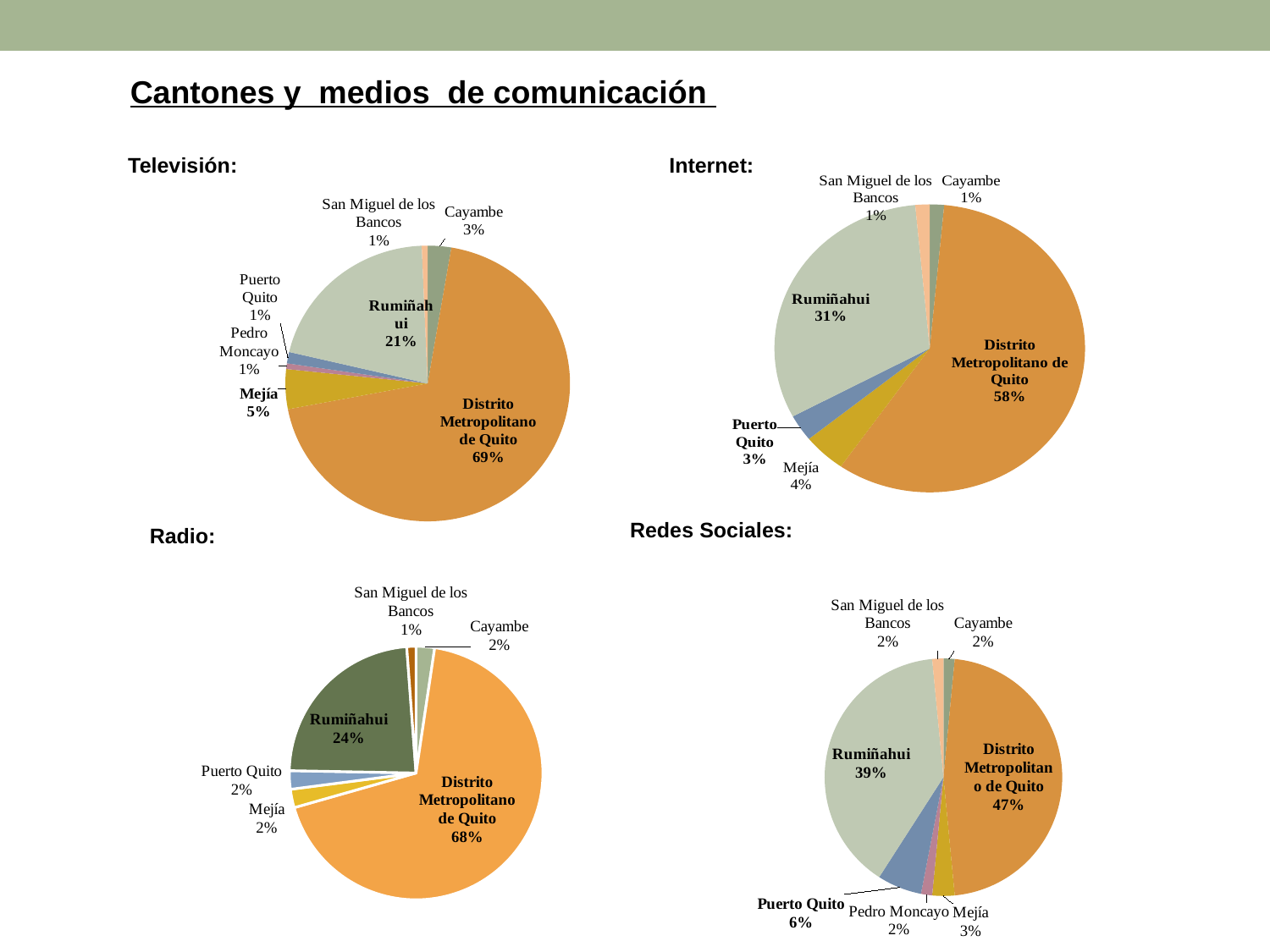
How many cantons are labelled in the Redes Sociales chart? 7 In the Televisión chart, what share does Distrito Metropolitano de Quito have? 69% In the Redes Sociales chart, which is larger, Puerto Quito or Mejía? Puerto Quito In the Televisión chart, what is the value for Mejía? 5% What kind of chart is used for the Televisión data? Pie chart How many pie charts are shown on the slide? 4 In the Radio chart, which canton has the smallest slice? San Miguel de los Bancos In the Internet chart, what share does Rumiñahui have? 31% In the Radio chart, what is the value for Rumiñahui? 24% In the Redes Sociales chart, what share does Distrito Metropolitano de Quito have? 47% In the Internet chart, what is the difference between Distrito Metropolitano de Quito and Rumiñahui? 27% In the Internet chart, which canton has the largest slice? Distrito Metropolitano de Quito